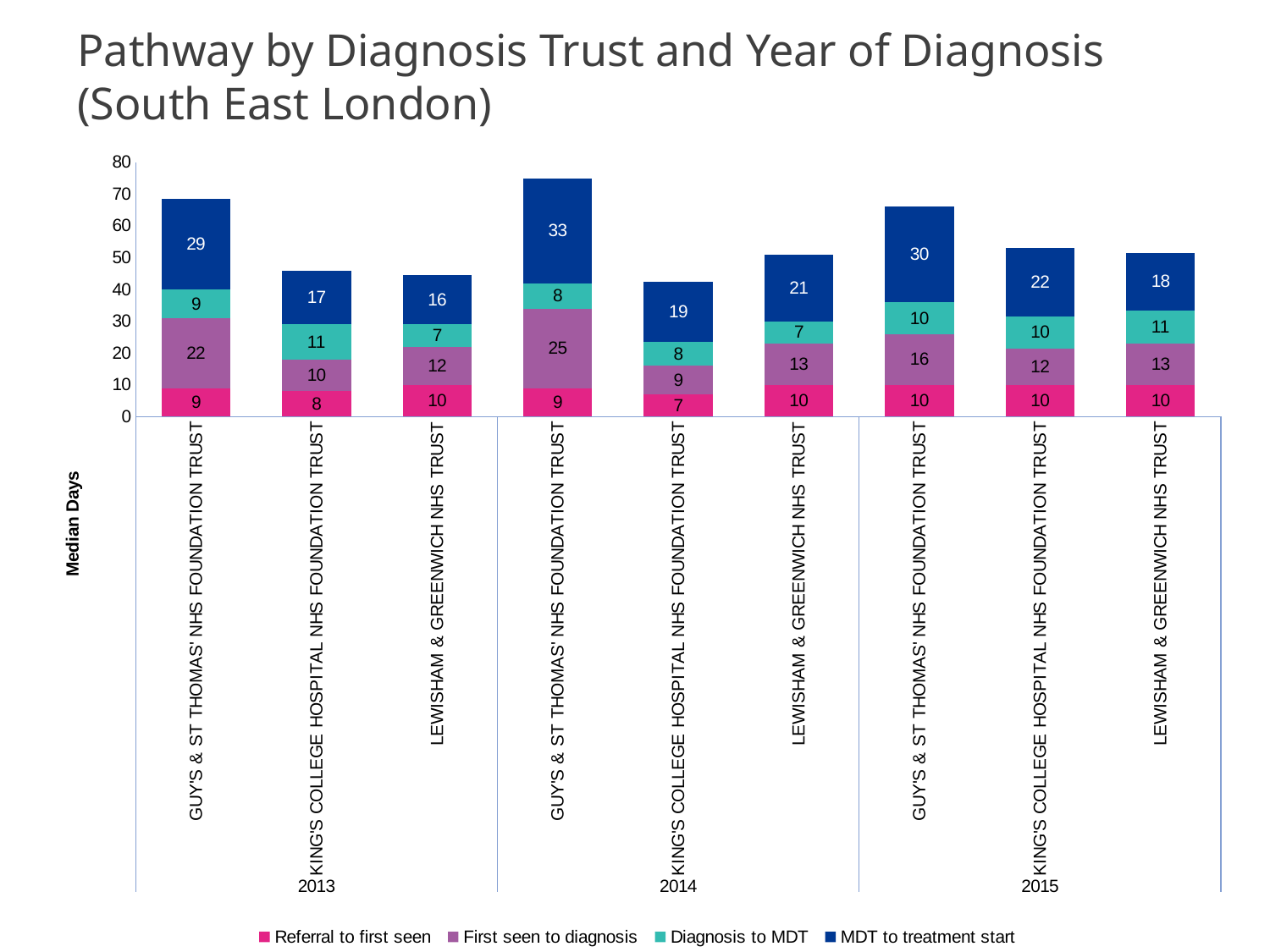
How many bars are plotted in the chart? 9 What is the difference between the MDT to treatment start values for Guy's & St Thomas' NHS Foundation Trust in 2014 and in 2013? 4 What is the total of the stacked bar for Guy's & St Thomas' NHS Foundation Trust in 2014? 75 Which bar has the highest MDT to treatment start value? Guy's & St Thomas' NHS Foundation Trust in 2014 What is the value of MDT to treatment start for Guy's & St Thomas' NHS Foundation Trust in 2014? 33 What kind of chart is shown on the slide? Stacked bar chart What is the value of First seen to diagnosis for Guy's & St Thomas' NHS Foundation Trust in 2013? 22 What is the value of Diagnosis to MDT for King's College Hospital NHS Foundation Trust in 2013? 11 What is the total of the stacked bar for King's College Hospital NHS Foundation Trust in 2013? 46 What is the value of Referral to first seen for King's College Hospital NHS Foundation Trust in 2014? 7 Which is larger: the First seen to diagnosis value for Lewisham & Greenwich NHS Trust in 2015 or for King's College Hospital NHS Foundation Trust in 2015? Lewisham & Greenwich NHS Trust in 2015 How many series does the legend list? 4